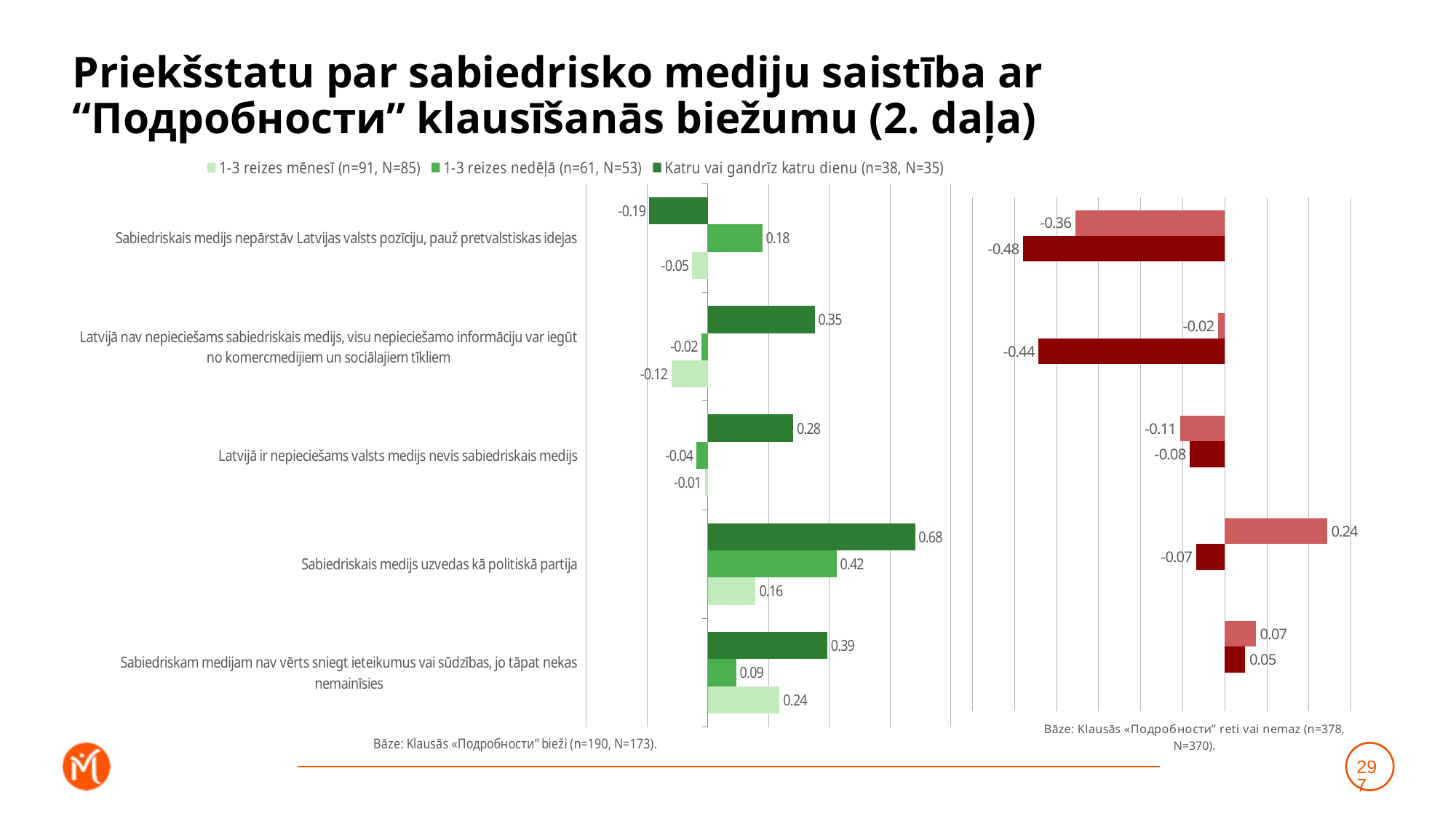
In the left (green) chart, what is the difference between the "Katru vai gandrīz katru dienu" and "1-3 reizes nedēļā" values for "Sabiedriskais medijs uzvedas kā politiskā partija"? 0.26 In the left (green) chart, what is the value for "1-3 reizes mēnesī" for "Sabiedriskam medijam nav vērts sniegt ieteikumus vai sūdzības, jo tāpat nekas nemainīsies"? 0.24 In the left (green) chart, which is larger for "Sabiedriskam medijam nav vērts sniegt ieteikumus vai sūdzības, jo tāpat nekas nemainīsies": the "1-3 reizes mēnesī" value or the "1-3 reizes nedēļā" value? 1-3 reizes mēnesī In the right (red) chart, what is the value of the darker red bar for "Sabiedriskais medijs nepārstāv Latvijas valsts pozīciju, pauž pretvalstiskas idejas"? -0.48 What kind of chart is the left (green) chart? Bar chart In the right (red) chart, what is the value of the lighter red bar for "Sabiedriskais medijs uzvedas kā politiskā partija"? 0.24 In the left (green) chart, what is the value for "Katru vai gandrīz katru dienu" for "Sabiedriskais medijs uzvedas kā politiskā partija"? 0.68 How many categories are shown in the left (green) chart? 5 In the left (green) chart, which category has the lowest value for "Katru vai gandrīz katru dienu"? Sabiedriskais medijs nepārstāv Latvijas valsts pozīciju, pauž pretvalstiskas idejas In the left (green) chart, what is the value for "1-3 reizes nedēļā" for "Sabiedriskais medijs nepārstāv Latvijas valsts pozīciju, pauž pretvalstiskas idejas"? 0.18 How many series does the legend of the left (green) chart list? 3 In the left (green) chart, which category has the highest value for "Katru vai gandrīz katru dienu"? Sabiedriskais medijs uzvedas kā politiskā partija